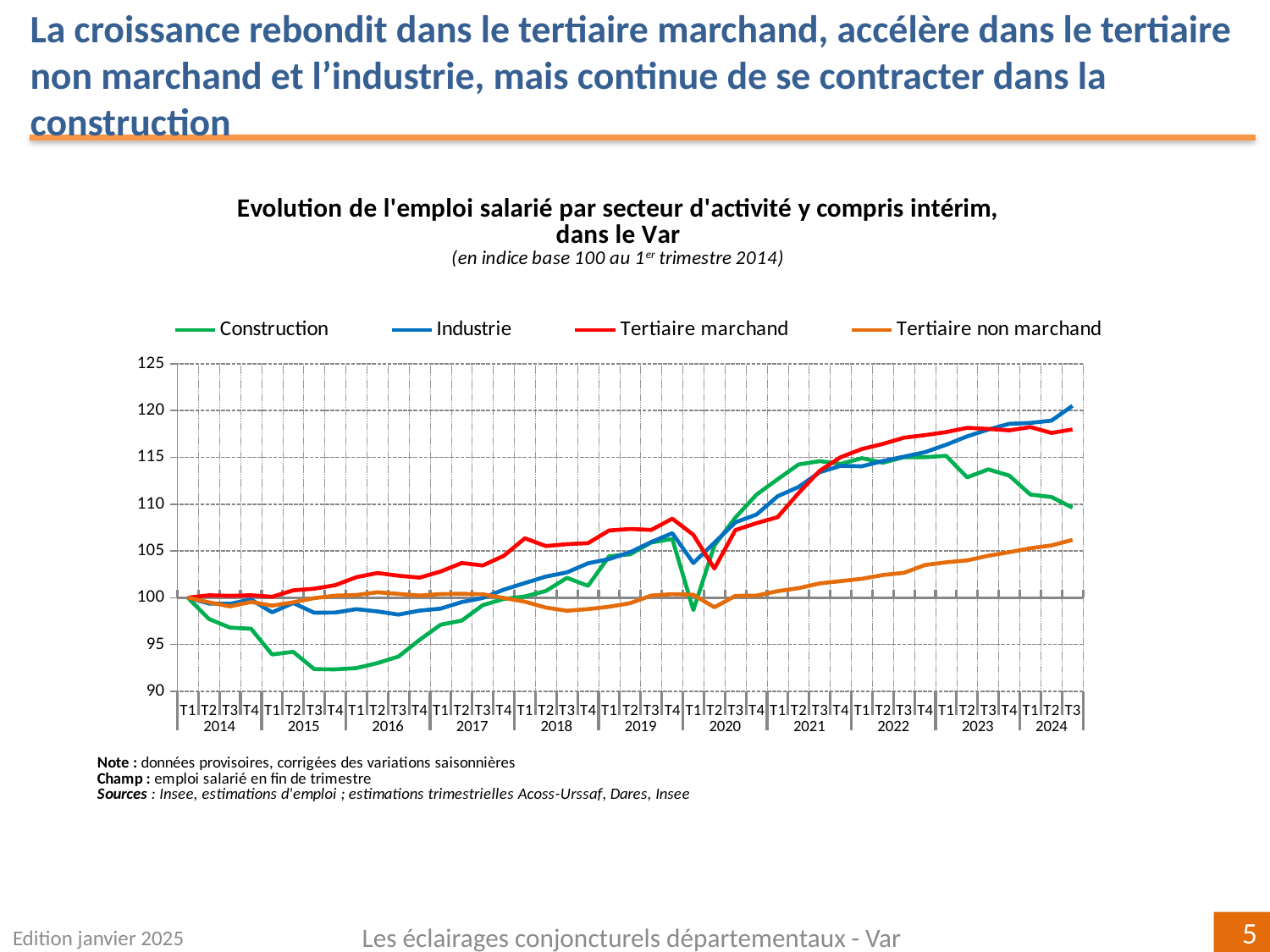
What is the index value of all series at T1 2014, the base quarter? 100 At T3 2024, which is higher: Tertiaire marchand or Tertiaire non marchand? Tertiaire marchand Which series has the lowest value at T3 2024? Tertiaire non marchand Is the value for Tertiaire marchand at T1 2020 greater or less than 105? greater Is the value for Industrie at T3 2024 greater or less than 115? greater How many years are labelled on the x axis? 11 What kind of chart is shown on the slide? Line chart How many series does the legend list? 4 Does the Construction series rise or fall between T1 2014 and T3 2015? Fall Which series has the highest value at T3 2024? Industrie Is the value for Construction at T3 2015 greater or less than 95? less Which series is shown in green in the legend? Construction